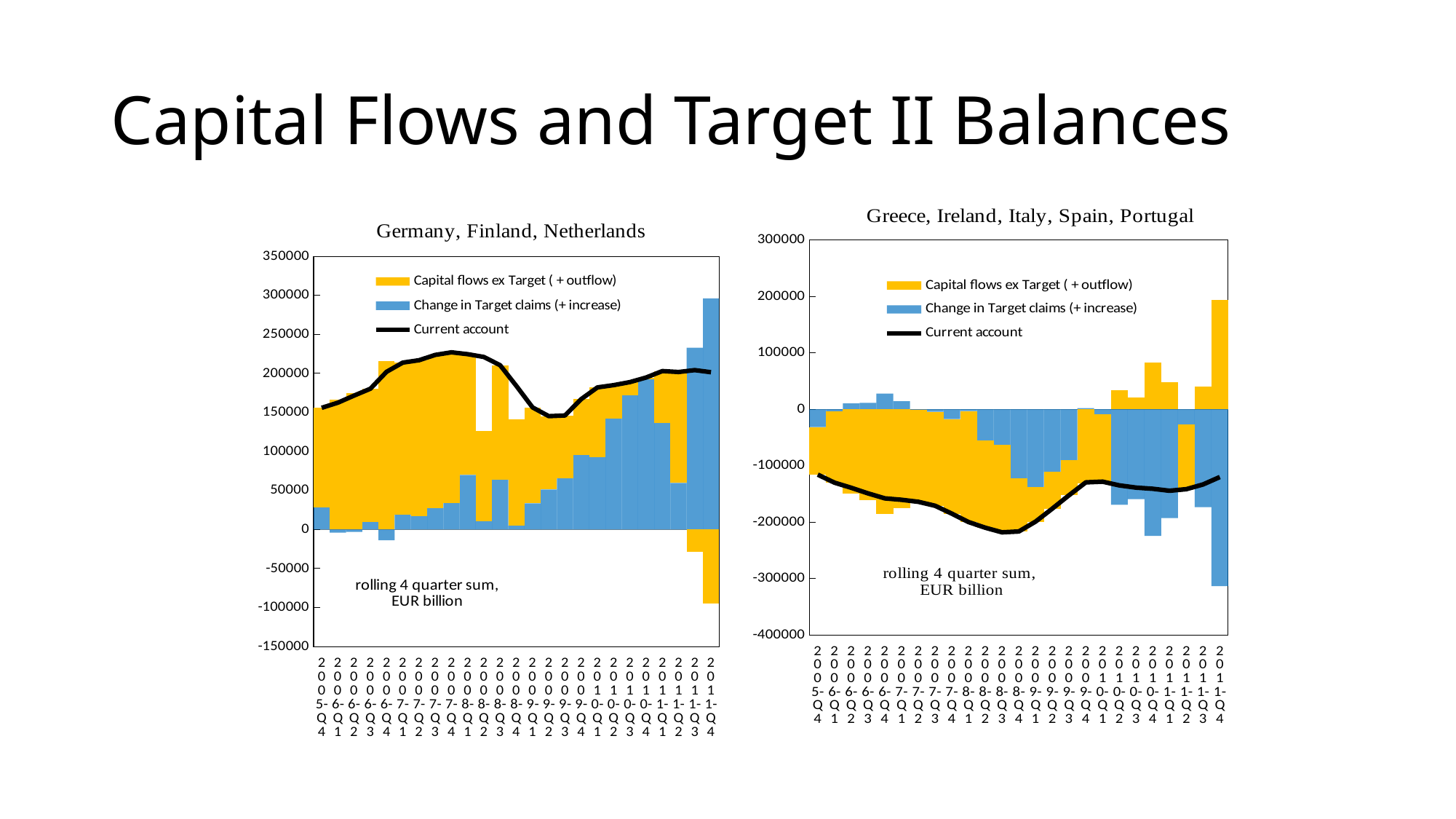
On the left chart (Germany, Finland, Netherlands), how many series does the legend list? 3 On the left chart, is the value of Capital flows ex Target for 2011-Q4 greater or less than -50000? less On the right chart (Greece, Ireland, Italy, Spain, Portugal), what are the three legend entries? Capital flows ex Target ( + outflow), Change in Target claims (+ increase), Current account On the right chart, is the Current account value for 2008-Q3 greater or less than -200000? less On the left chart, is the Current account value for 2008-Q1 greater or less than 200000? greater On the left chart, how many quarters are shown on the x axis? 25 What kind of chart is the right chart (Greece, Ireland, Italy, Spain, Portugal)? Stacked bar chart with a line On the right chart, does the Current account line rise or fall from 2005-Q4 to 2008-Q3? fall What unit note is printed inside both charts? rolling 4 quarter sum, EUR billion